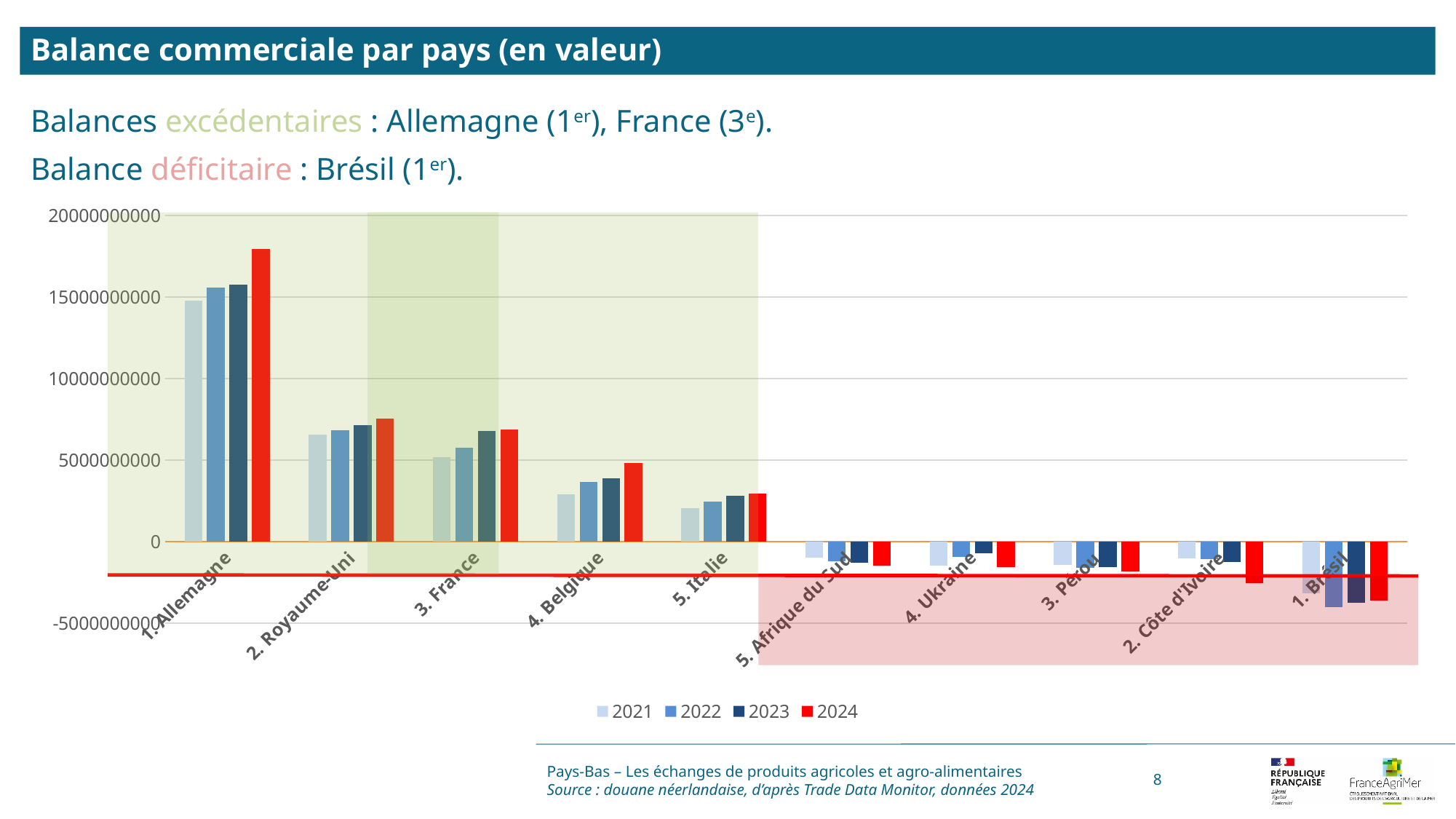
Is the 2024 value for 5. Afrique du Sud greater or less than -5000000000? greater Is the 2024 value for 2. Royaume-Uni greater or less than 5000000000? greater What kind of chart is shown on the slide? bar chart Which country has the lowest 2024 value in the chart? 1. Brésil Is the 2021 value for 4. Belgique greater or less than 5000000000? less How many series does the chart legend list? 4 Do the values for 1. Allemagne rise or fall from 2021 to 2024? rise Which country has the highest 2024 value in the chart? 1. Allemagne How many countries are shown on the x axis of the chart? 10 Which is larger, the 2024 value for 1. Allemagne or the 2024 value for 2. Royaume-Uni? 1. Allemagne What is the title of the slide containing the chart? Balance commerciale par pays (en valeur)